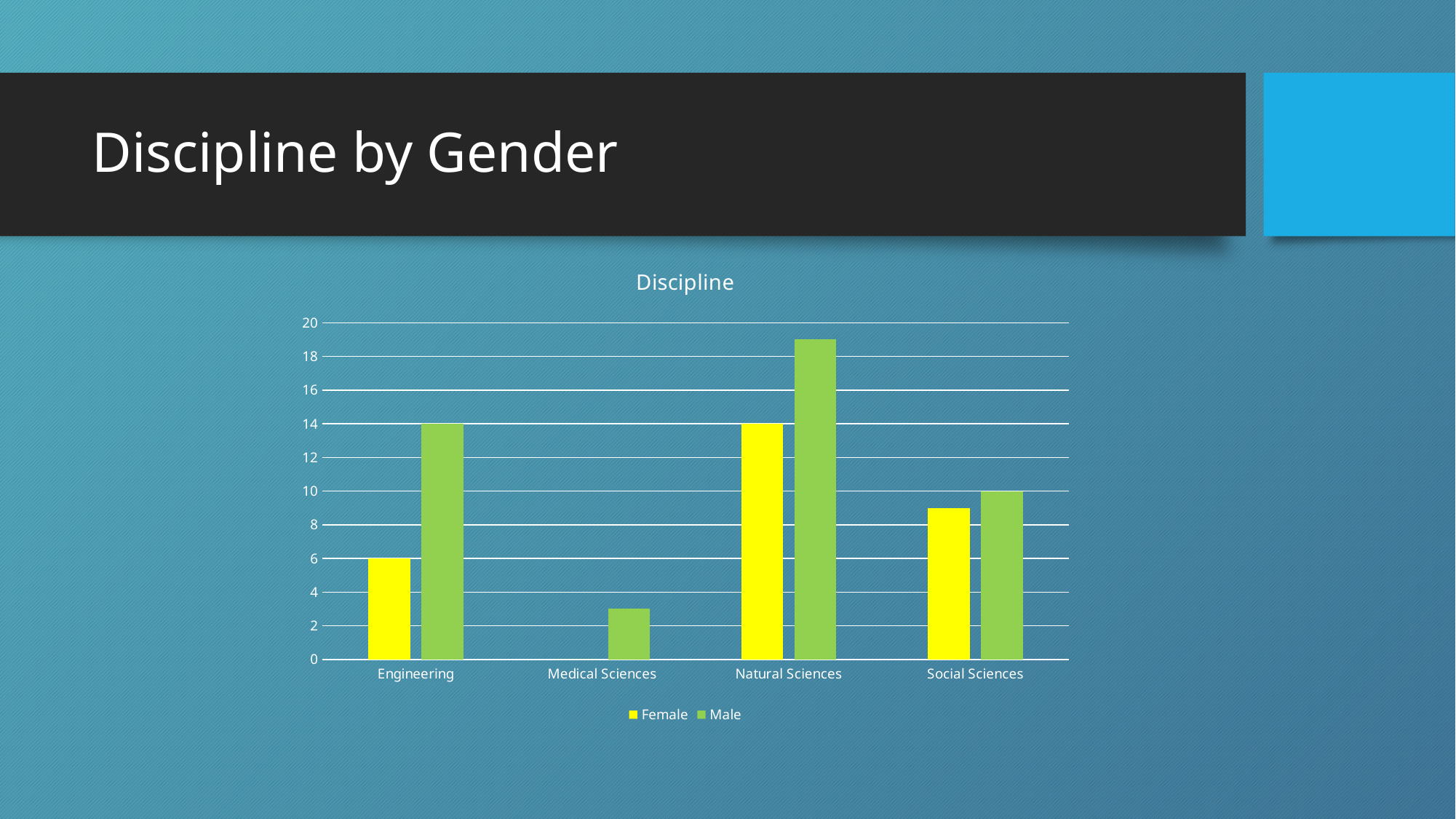
Which discipline has the highest Male value? Natural Sciences What is the difference between the Male and Female values for Engineering? 8 Is the Male value for Natural Sciences greater or less than 18? greater How many disciplines are shown on the x axis? 4 What is the Female value for Natural Sciences? 14 What kind of chart is shown on the slide? bar chart What is the Female value for Engineering? 6 For Engineering, which is larger, the Male value or the Female value? Male What is the Male value for Engineering? 14 What is the Male value for Social Sciences? 10 Which discipline has the lowest Male value? Medical Sciences How many series does the legend list? 2